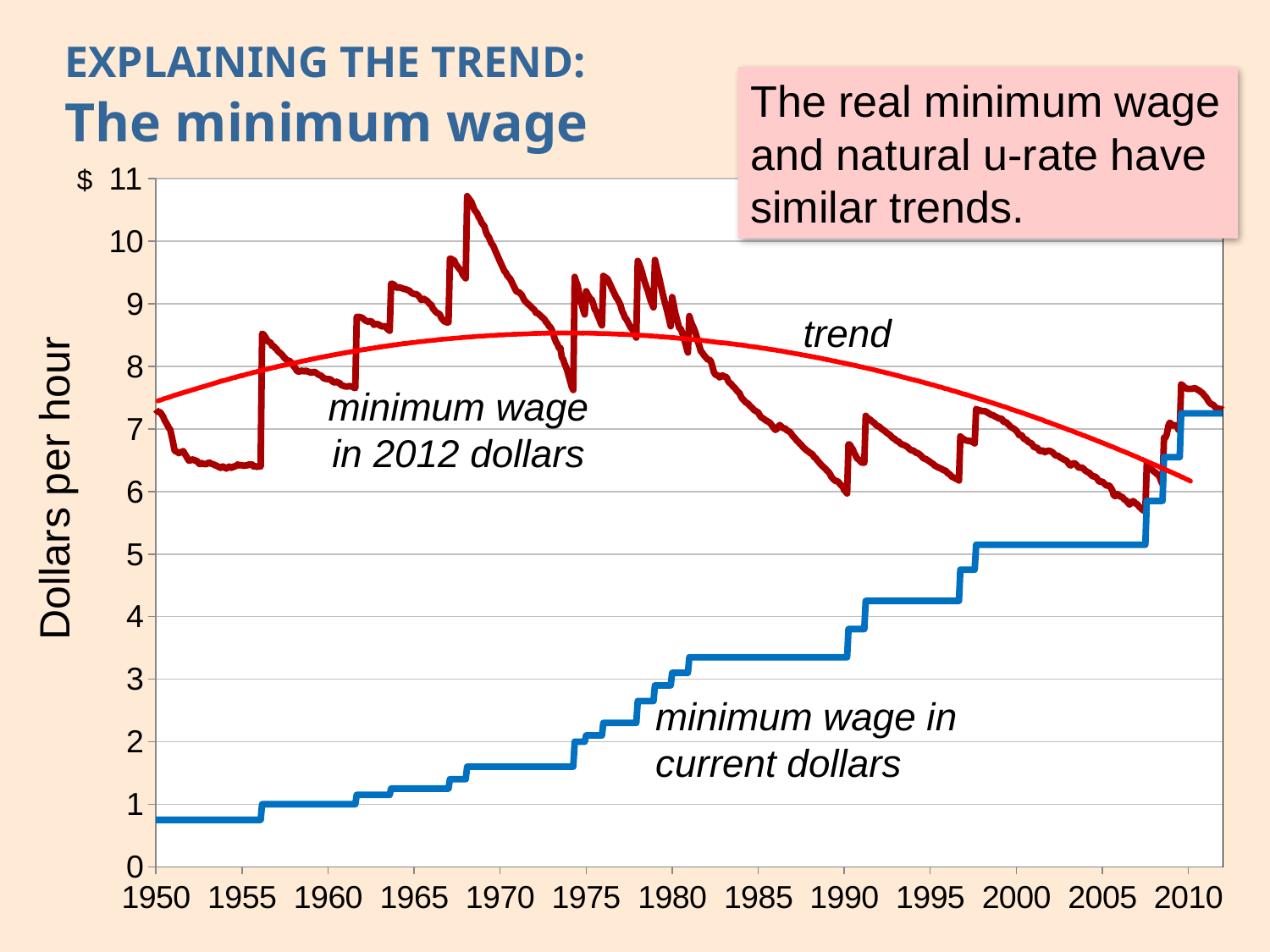
Is the minimum wage in current dollars in 1985 greater or less than 4? less What is the label of the vertical axis? Dollars per hour What kind of chart is shown on the slide? line chart Is the minimum wage in 2012 dollars in 1955 greater or less than 7? less Is the minimum wage in current dollars in 1950 greater or less than 1? less Does the minimum wage in 2012 dollars rise or fall from 1968 to 2006? fall What is the highest value shown on the vertical axis? 11 How many data series are plotted on the chart? 2 Does the minimum wage in current dollars rise or fall from 1950 to 2010? rise In 1970, which is higher: the minimum wage in 2012 dollars or the minimum wage in current dollars? minimum wage in 2012 dollars